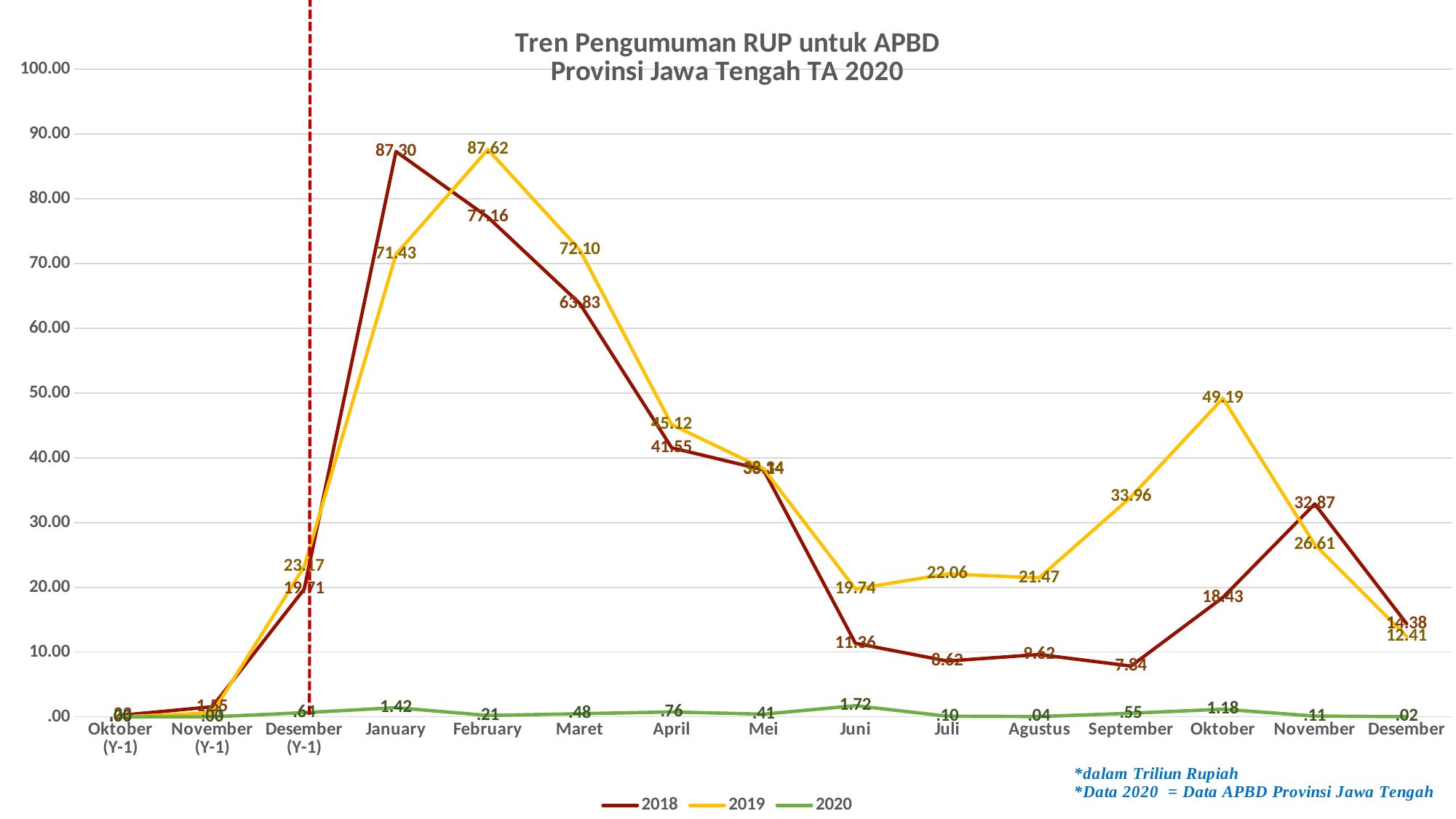
Is the value for 2018 in Maret greater or less than 60? greater What is the difference between the 2019 and 2018 values in Oktober? 30.76 In November, which series has the larger value, 2018 or 2019? 2018 How many months (categories) are plotted along the x axis? 15 What kind of chart is shown on the slide? Line chart What is the value for 2019 in Oktober? 49.19 How many series does the legend list? 3 What is the value for 2019 in February? 87.62 Does the 2018 series rise or fall from January to September? Fall What is the value for 2018 in January? 87.30 In which month does the 2019 series reach its highest value? February What is the value for 2020 in Juni? 1.72